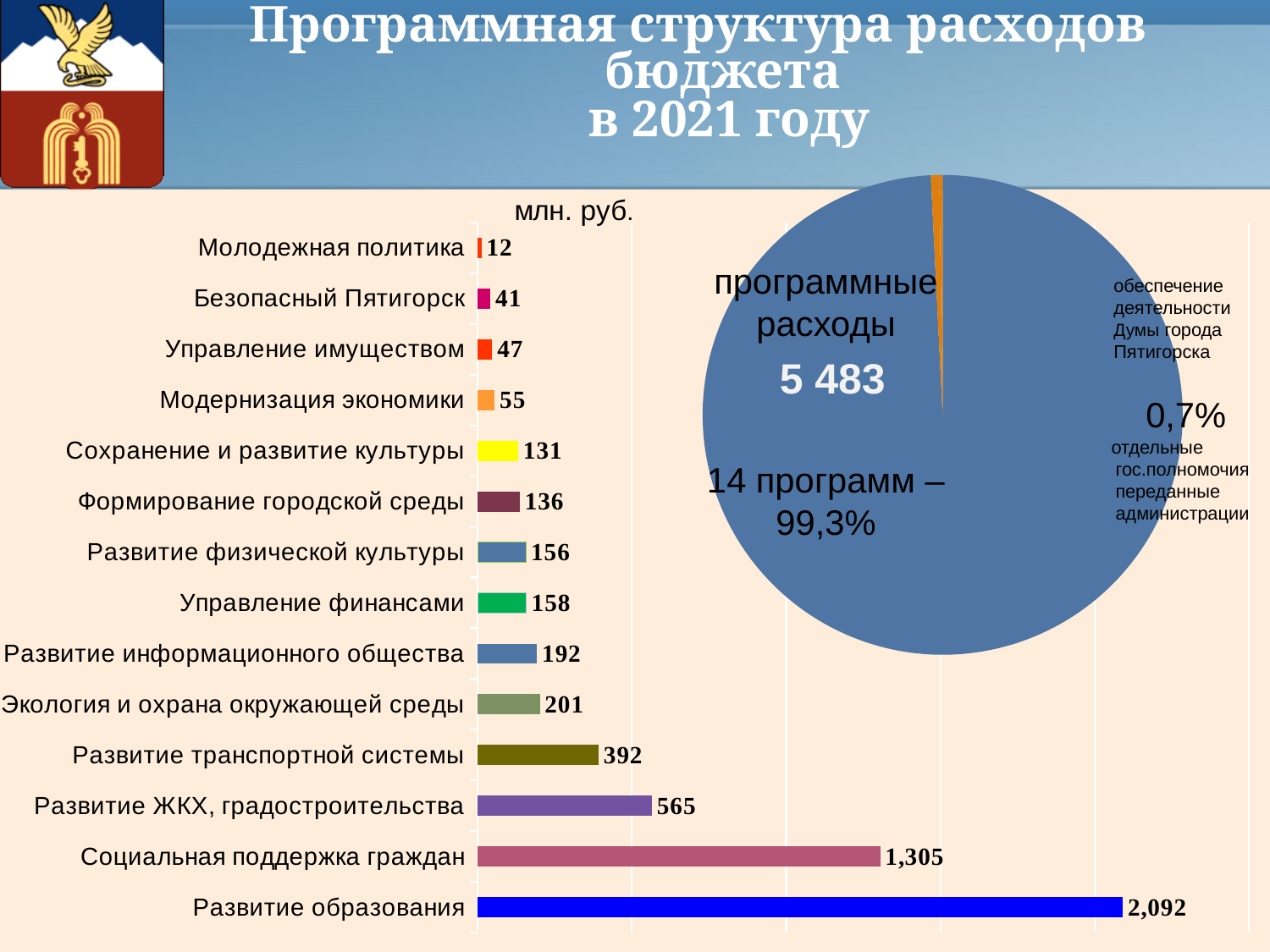
What kind of chart is the chart on the left side of the slide? Bar chart On the bar chart, what is the value for Развитие образования? 2,092 On the bar chart, which category has the lowest value? Молодежная политика On the pie chart, what share is shown for the 14 программ (программные расходы) slice? 99,3% On the pie chart, what share is shown for the small orange slice? 0,7% On the bar chart, what is the difference between Развитие ЖКХ, градостроительства and Развитие транспортной системы? 173 On the bar chart, which category has the highest value? Развитие образования How many categories does the bar chart show? 14 On the bar chart, what is the value for Развитие транспортной системы? 392 On the bar chart, which is larger: Экология и охрана окружающей среды or Развитие информационного общества? Экология и охрана окружающей среды On the bar chart, what is the value for Социальная поддержка граждан? 1,305 On the pie chart, what total value is printed for программные расходы? 5 483